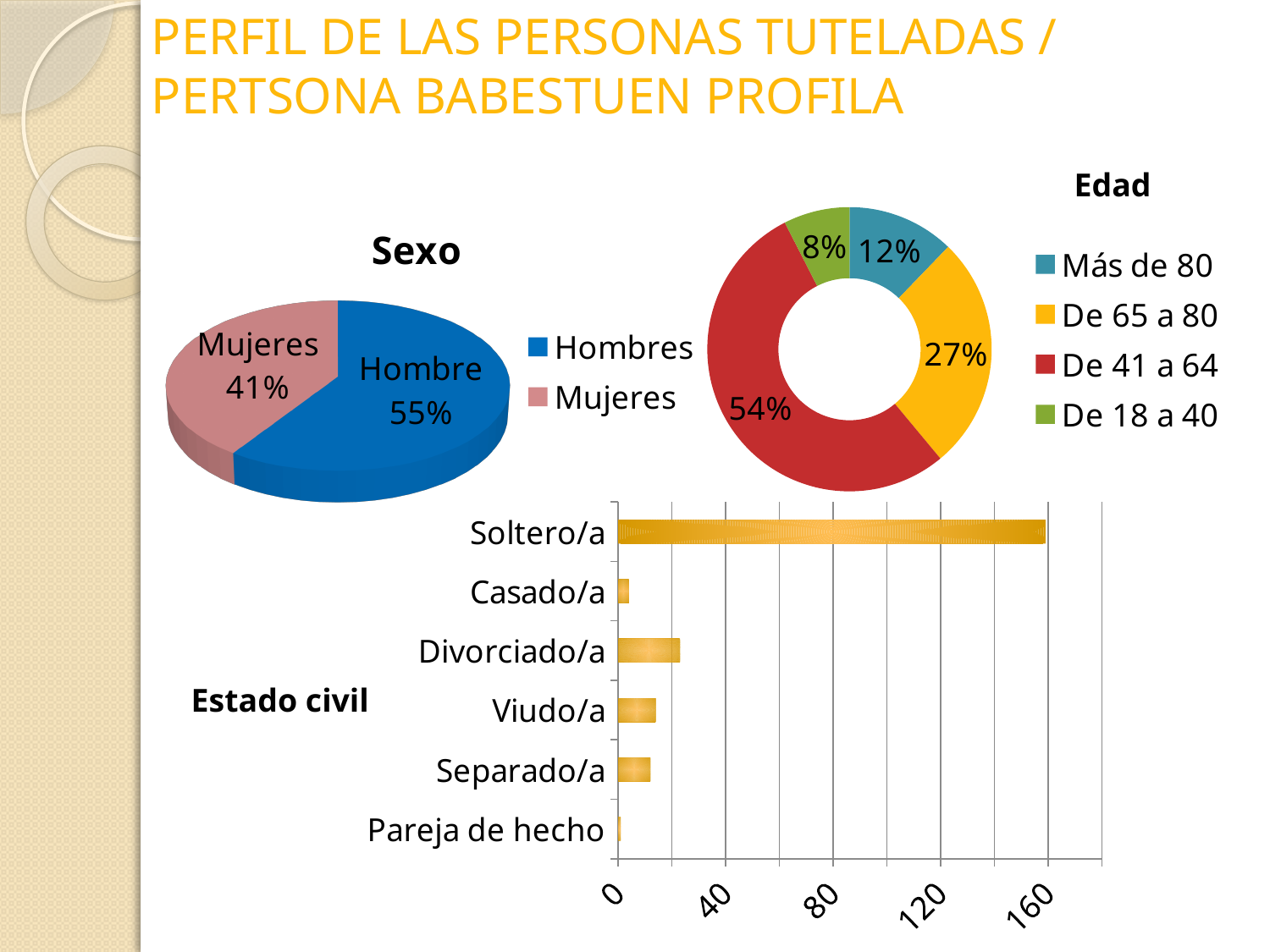
In the Estado civil bar chart, is the value for Soltero/a greater or less than 120? greater How many categories does the legend of the Edad doughnut chart list? 4 In the Sexo pie chart, what percentage is shown for Hombres? 55% In the Edad doughnut chart, what percentage is shown for De 41 a 64? 54% In the Estado civil bar chart, which category has the highest value? Soltero/a In the Sexo pie chart, what percentage is shown for Mujeres? 41% In the Edad doughnut chart, which age group has the smallest share? De 18 a 40 How many categories are shown in the Estado civil bar chart? 6 In the Edad doughnut chart, what percentage is shown for Más de 80? 12% In the Edad doughnut chart, what is the difference in percentage points between De 65 a 80 and De 18 a 40? 19 In the Sexo pie chart, which group has the larger share, Hombres or Mujeres? Hombres What kind of chart is the Estado civil chart? Bar chart